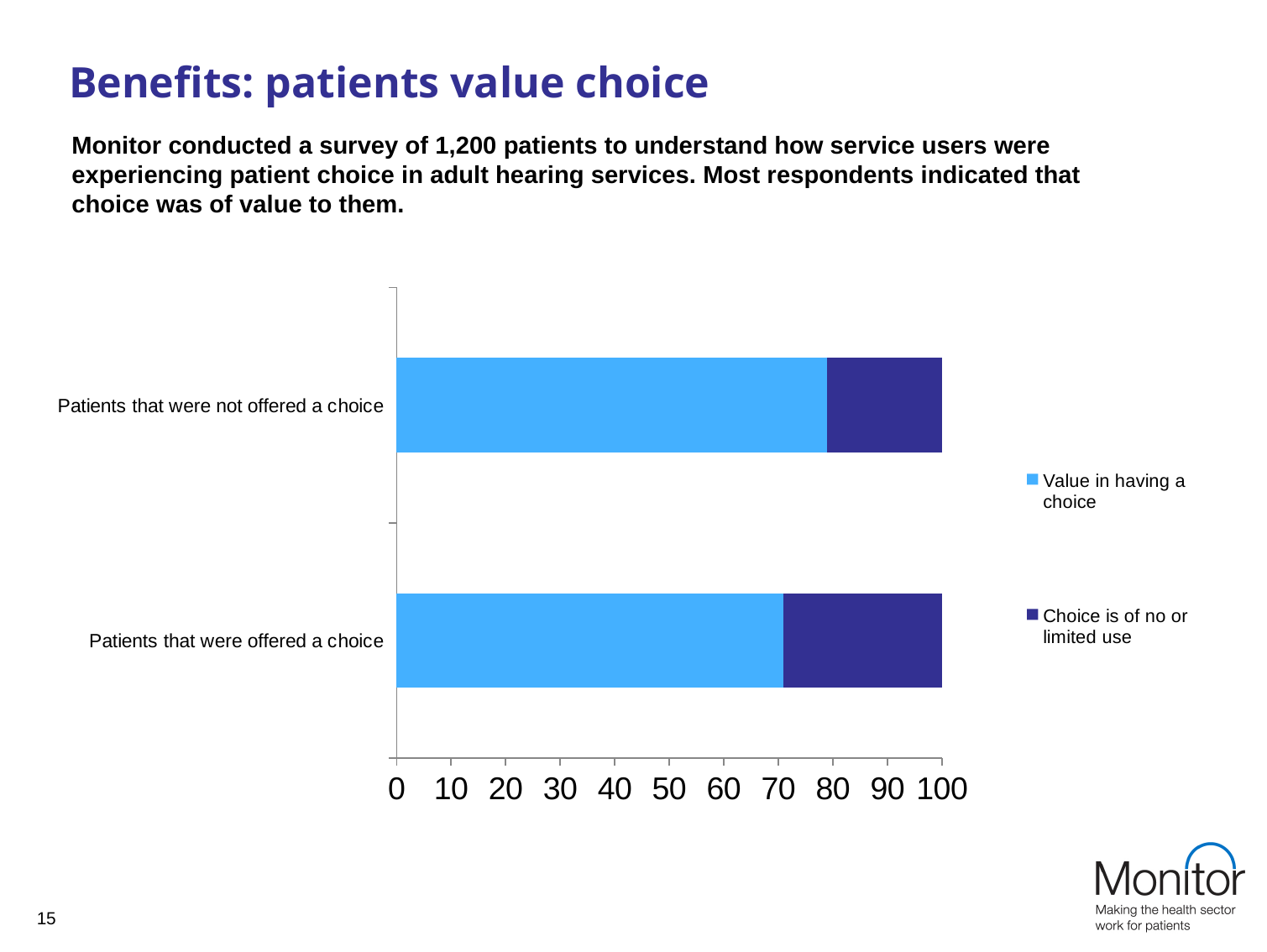
What kind of chart is shown on the slide? Stacked bar chart Is the 'Value in having a choice' segment for 'Patients that were offered a choice' greater or less than 60? greater What is the highest value shown on the x axis? 100 Is the 'Value in having a choice' segment for 'Patients that were not offered a choice' greater or less than 70? greater Which category has the larger 'Choice is of no or limited use' segment? Patients that were offered a choice Which colour represents 'Value in having a choice' in the chart? Light blue How many series does the chart's legend list? 2 Which category has the larger 'Value in having a choice' segment? Patients that were not offered a choice Is the 'Value in having a choice' segment for 'Patients that were offered a choice' greater or less than 80? less How many categories are plotted on the chart? 2 What is the total of the stacked bar for 'Patients that were offered a choice'? 100 What are the two series named in the legend? Value in having a choice; Choice is of no or limited use